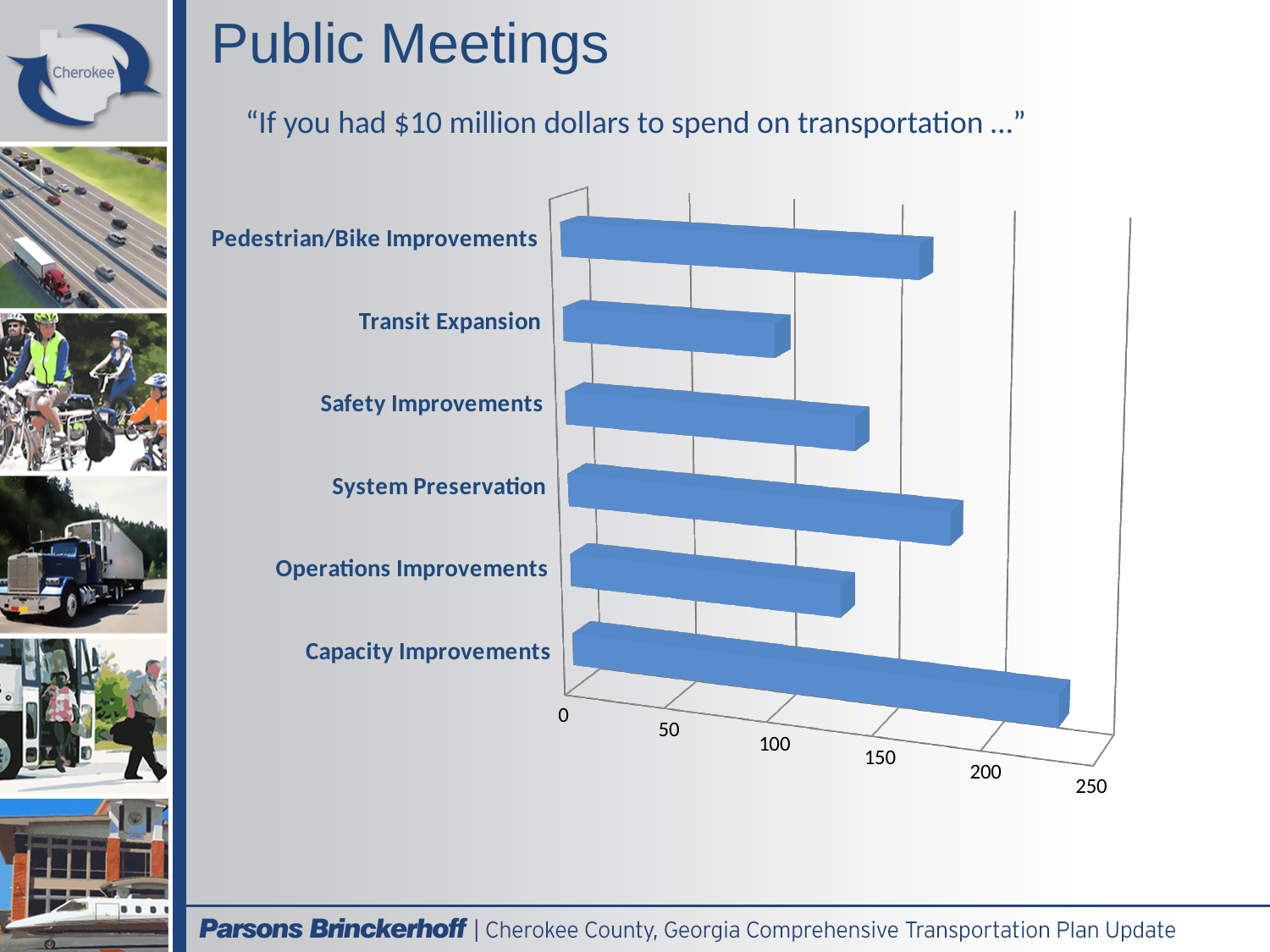
What question is the chart on the slide based on? "If you had $10 million dollars to spend on transportation ..." What kind of chart is shown on the slide? bar chart Which category has the highest value in the chart? Capacity Improvements How many categories are shown in the chart? 6 Which is larger, the value for System Preservation or the value for Operations Improvements? System Preservation Is the value for Operations Improvements greater or less than 150? less Which is larger, the value for Pedestrian/Bike Improvements or the value for Safety Improvements? Pedestrian/Bike Improvements Is the value for Capacity Improvements greater or less than 200? greater Is the value for Safety Improvements greater or less than 100? greater Which is larger, the value for Capacity Improvements or the value for Transit Expansion? Capacity Improvements Which category has the lowest value in the chart? Transit Expansion